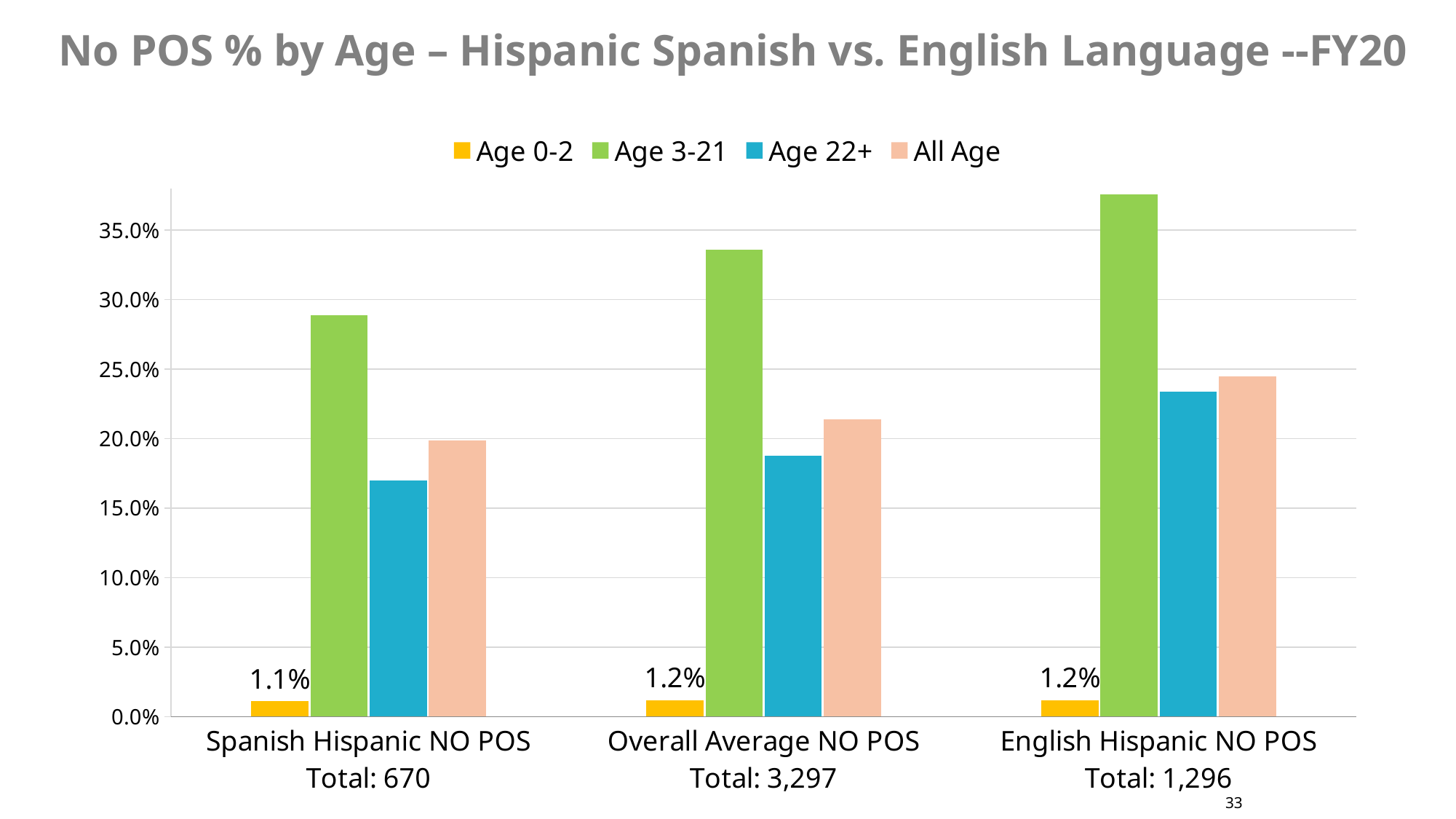
Which category has the highest Age 3-21 value? English Hispanic NO POS What is the Age 0-2 value for English Hispanic NO POS? 1.2% Is the Age 3-21 value for Spanish Hispanic NO POS greater or less than 25.0%? greater What is the Age 0-2 value for Overall Average NO POS? 1.2% How many categories are shown on the x axis? 3 Which category has the lowest All Age value? Spanish Hispanic NO POS What kind of chart is shown on the slide? Bar chart Is the Age 22+ value for Overall Average NO POS greater or less than 20.0%? less Which is larger: the Age 22+ value for English Hispanic NO POS or the Age 22+ value for Spanish Hispanic NO POS? English Hispanic NO POS What is the Age 0-2 value for Spanish Hispanic NO POS? 1.1% How many series does the legend list? 4 Is the Age 3-21 value for English Hispanic NO POS greater or less than 35.0%? greater